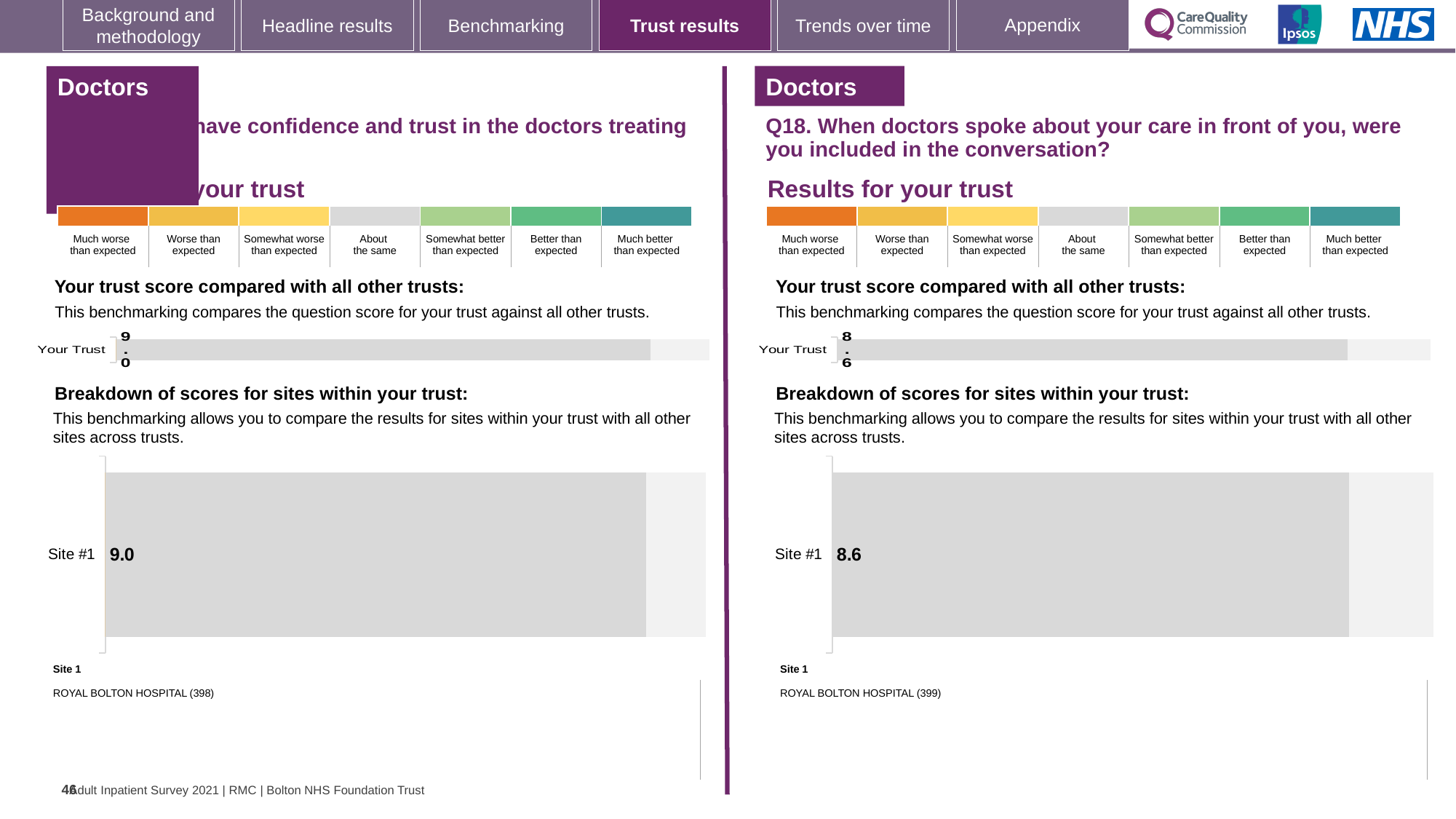
On the left panel, which hospital is listed as Site 1? ROYAL BOLTON HOSPITAL (398) On the right panel (Q18), what value is shown for 'Your Trust' in the trust score comparison bar? 8.6 On the right panel (Q18), which hospital is listed as Site 1? ROYAL BOLTON HOSPITAL (399) Which is larger: the Site #1 score on the left panel or the Site #1 score on the right panel (Q18)? Left panel (9.0) How many sites are shown in the breakdown of scores chart on the right panel (Q18)? 1 What is the difference between the Site #1 score on the left panel and the Site #1 score on the right panel (Q18)? 0.4 On the right panel (Q18), what is the score shown for Site #1 in the breakdown of scores for sites within your trust? 8.6 On the left panel, what value is shown for 'Your Trust' in the trust score comparison bar? 9.0 On the right panel (Q18), is the Site #1 score greater or less than the 'Your Trust' score on the same panel, or are they equal? Equal (8.6) On the left panel, what is the score shown for Site #1 in the breakdown of scores for sites within your trust? 9.0 What type of chart is used for the breakdown of scores for sites within your trust on the left panel? Bar chart